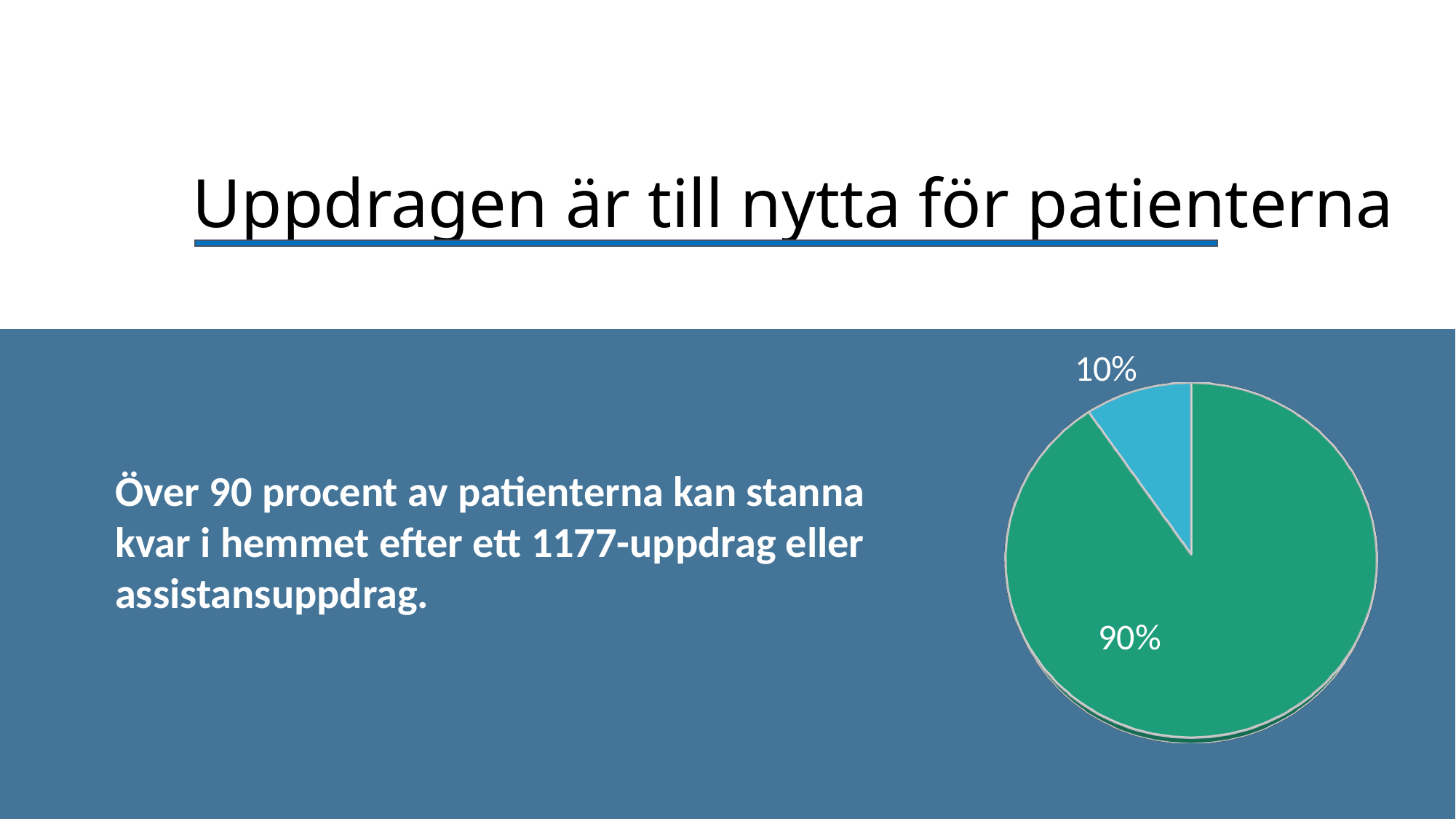
What kind of chart is shown on the slide? pie chart Which slice is larger in the pie chart, the green one or the light blue one? the green one What is the value shown on the largest slice of the pie chart? 90% Does the pie chart include a legend? No What share of the pie does the green slice represent? 90% What value is labelled on the light blue slice of the pie chart? 10% What value is labelled on the green slice of the pie chart? 90% What is the value shown on the smallest slice of the pie chart? 10% What colour is the slice labelled 10%? light blue Is the value of the light blue slice greater or less than 50%? less How many slices does the pie chart have? 2 What is the difference between the two slice values in the pie chart? 80%